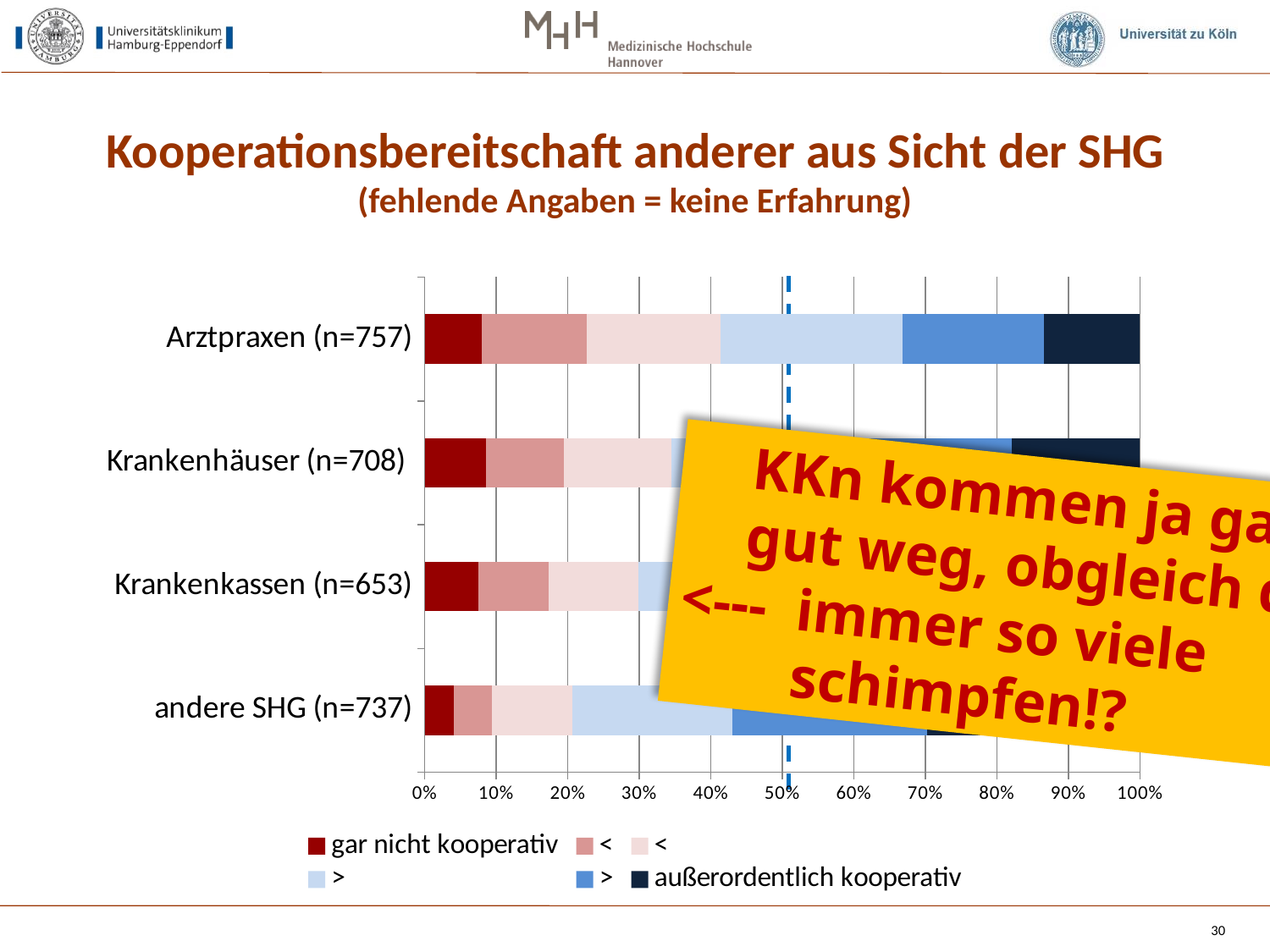
What is the main title of the chart slide? Kooperationsbereitschaft anderer aus Sicht der SHG How many categories (rows) does the bar chart show? 4 What is the sample size (n) given for Arztpraxen? 757 Is the 'gar nicht kooperativ' share for Arztpraxen greater or less than 10%? less How many series does the legend list? 6 Which has the larger 'gar nicht kooperativ' segment, Arztpraxen or andere SHG? Arztpraxen Which category has the smallest 'gar nicht kooperativ' segment? andere SHG (n=737) Is the 'gar nicht kooperativ' share for andere SHG greater or less than 10%? less What is the sample size (n) given for Krankenkassen? 653 Which legend entry is listed first? gar nicht kooperativ What kind of chart is shown on the slide? stacked bar chart What is the highest value shown on the horizontal axis? 100%